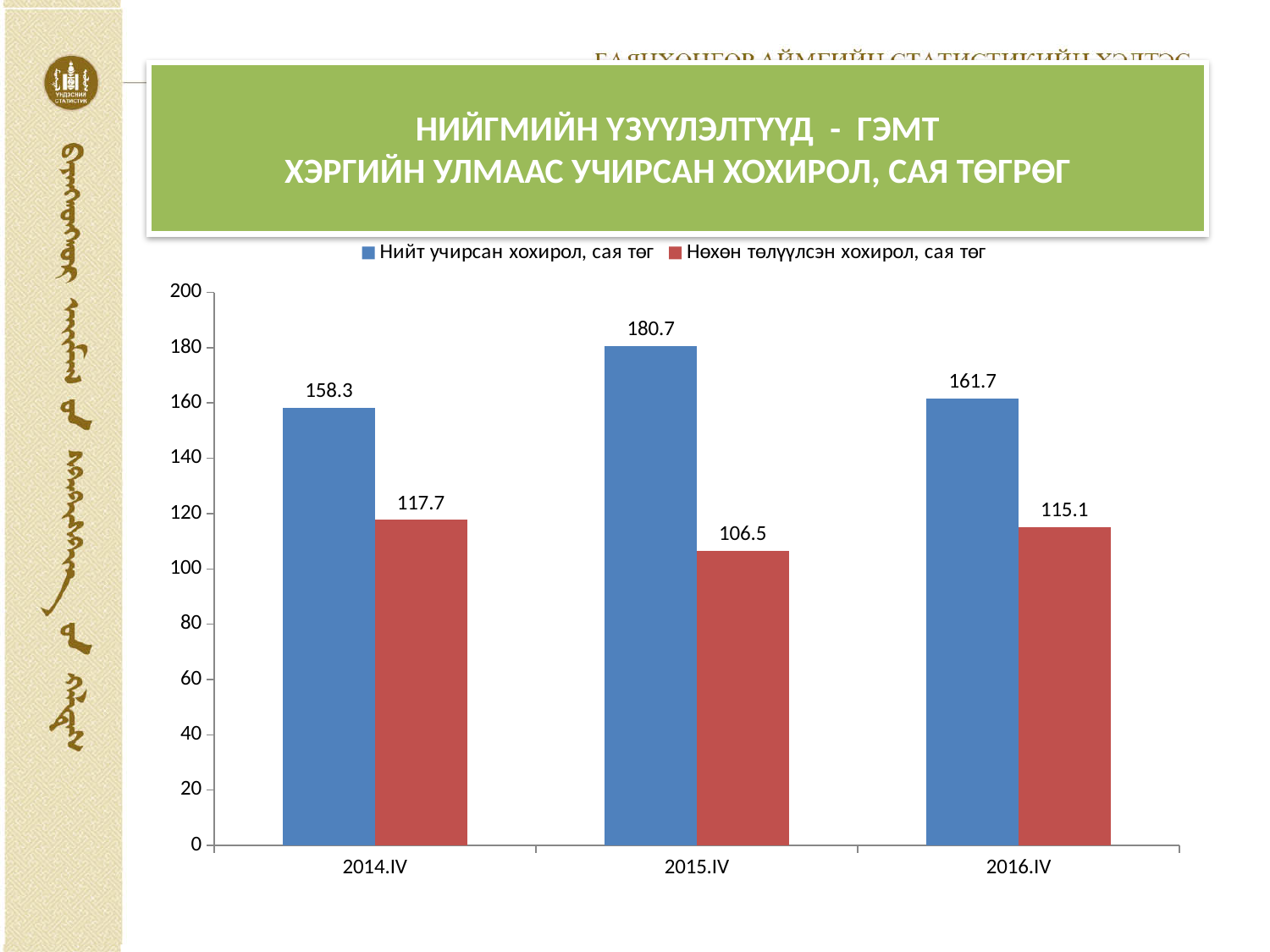
Which is larger: 'Нөхөн төлүүлсэн хохирол, сая төг' in 2014.IV or in 2016.IV? 2014.IV Which colour represents 'Нөхөн төлүүлсэн хохирол, сая төг' in the chart? Red Which period has the highest value for 'Нийт учирсан хохирол, сая төг'? 2015.IV What kind of chart is shown on the slide? Bar chart How many periods are shown on the x axis? 3 What is the value of 'Нөхөн төлүүлсэн хохирол, сая төг' for 2016.IV? 115.1 How many series does the legend list? 2 Which period has the lowest value for 'Нөхөн төлүүлсэн хохирол, сая төг'? 2015.IV What is the difference between 'Нийт учирсан хохирол, сая төг' and 'Нөхөн төлүүлсэн хохирол, сая төг' in 2015.IV? 74.2 What is the value of 'Нийт учирсан хохирол, сая төг' for 2014.IV? 158.3 What is the value of 'Нийт учирсан хохирол, сая төг' for 2015.IV? 180.7 Is the value for 'Нийт учирсан хохирол, сая төг' in 2016.IV greater or less than 140? greater